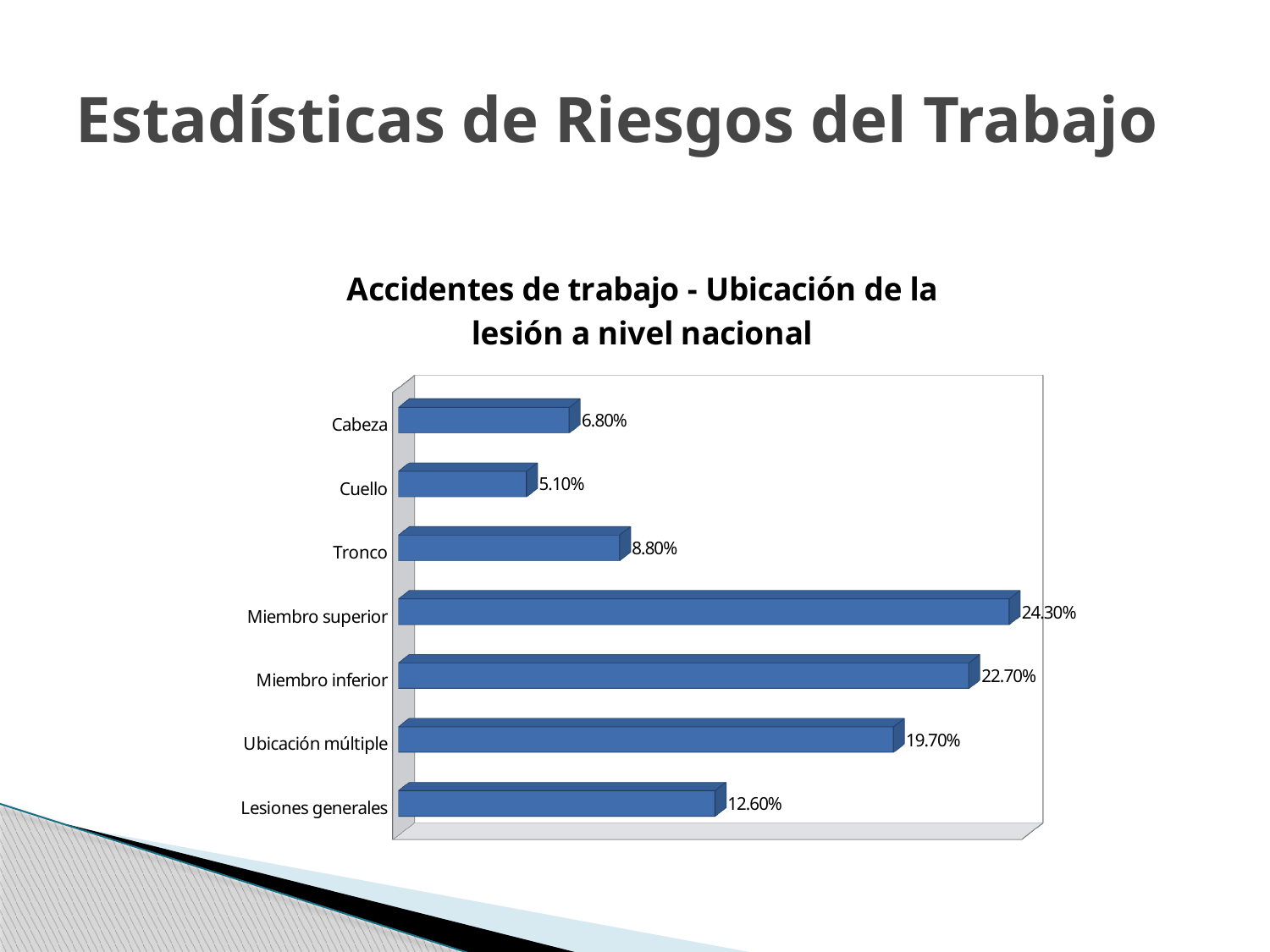
What is the value for Cuello? 5.10% What is the title of the chart? Accidentes de trabajo - Ubicación de la lesión a nivel nacional What is the difference between Miembro superior and Miembro inferior? 1.60% Which is larger, Cabeza or Tronco? Tronco What is the value for Tronco? 8.80% What is the value for Lesiones generales? 12.60% Which category has the highest value? Miembro superior What is the value for Miembro superior? 24.30% Which category has the lowest value? Cuello What kind of chart is shown? Bar chart What is the difference between Ubicación múltiple and Lesiones generales? 7.10% How many categories are shown in the chart? 7